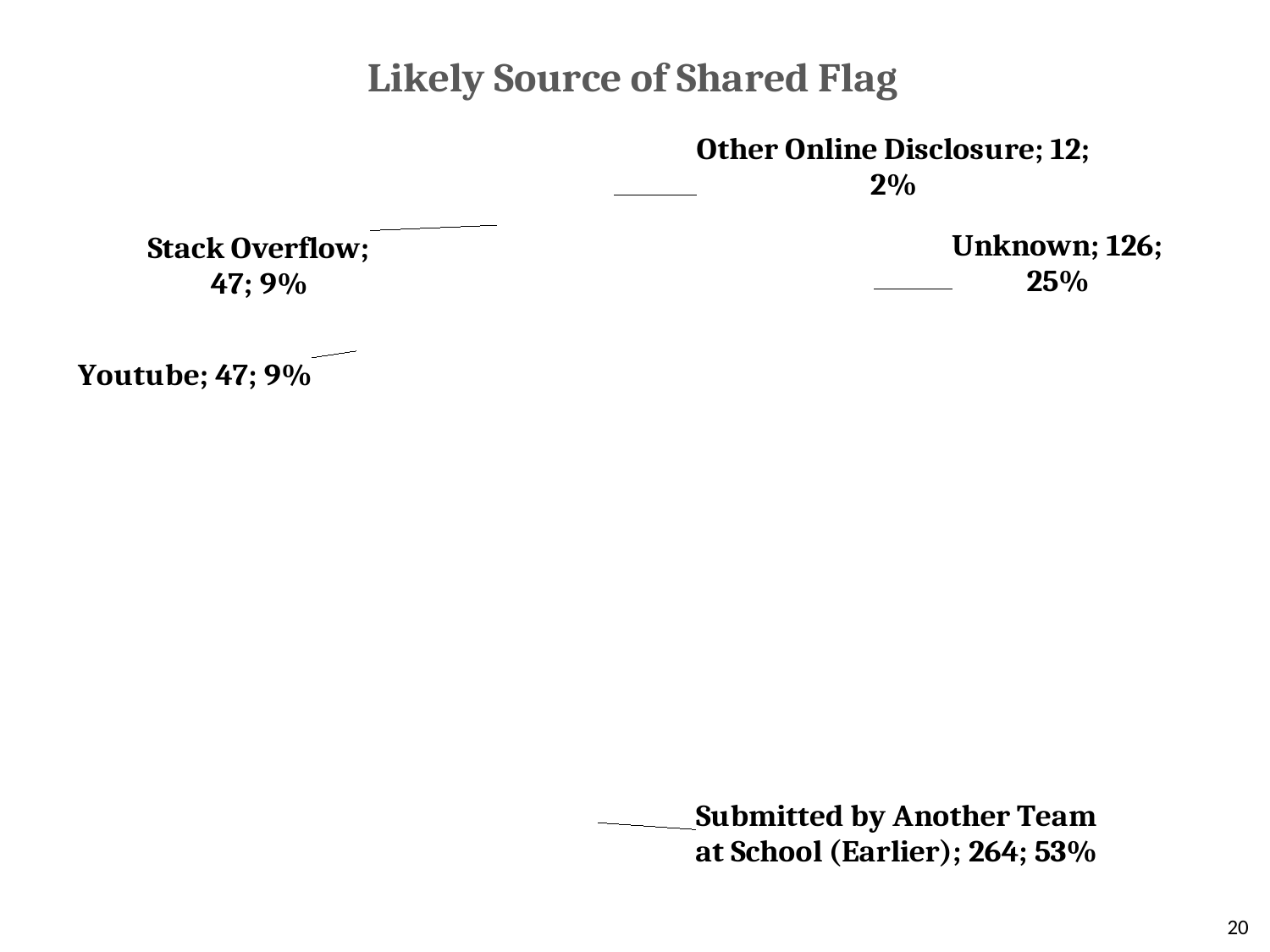
Which is larger, the value for Unknown or the value for Youtube? Unknown How many categories are shown in the chart? 5 Which category has the highest value? Submitted by Another Team at School (Earlier) What is the title of the chart? Likely Source of Shared Flag What share of the pie does Youtube represent? 9% What is the value for Unknown? 126 What is the difference between the values for Submitted by Another Team at School (Earlier) and Unknown? 138 What is the value for Other Online Disclosure? 12 What share of the pie does Unknown represent? 25% What is the value for Stack Overflow? 47 Which category has the lowest value? Other Online Disclosure What is the value for Submitted by Another Team at School (Earlier)? 264